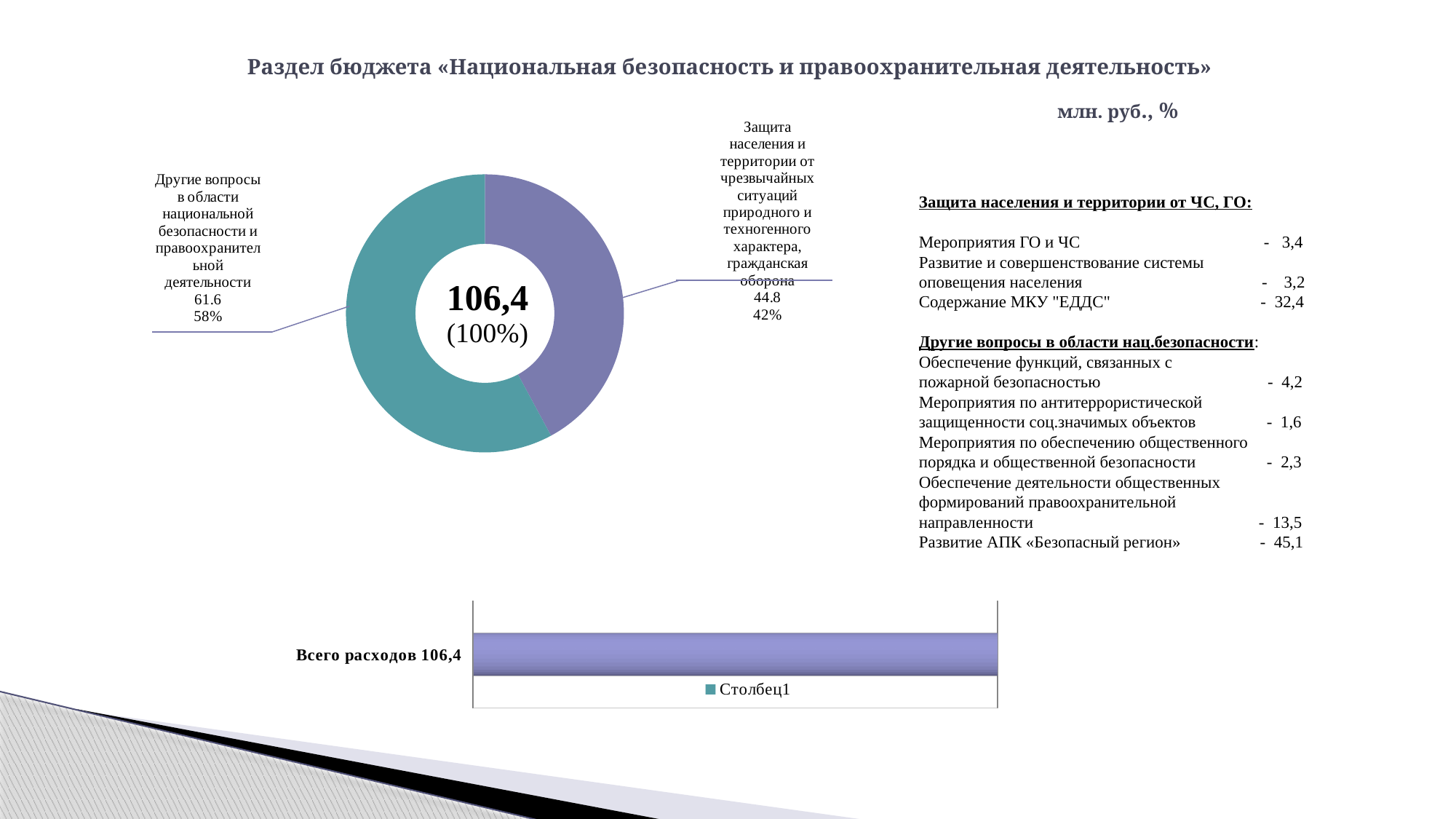
In the donut chart, what value is shown for «Другие вопросы в области национальной безопасности и правоохранительной деятельности»? 61.6 What type of chart is shown on the left side of the slide? Donut (pie) chart In the donut chart, what value is shown for «Защита населения и территории от чрезвычайных ситуаций природного и техногенного характера, гражданская оборона»? 44.8 In the donut chart, what percentage share does «Другие вопросы в области национальной безопасности и правоохранительной деятельности» have? 58% In the bar chart at the bottom of the slide, what is the label of the single bar? Всего расходов 106,4 How many slices does the donut chart have? 2 In the bar chart at the bottom of the slide, what series name does the legend show? Столбец1 In the donut chart, which category has the smaller value? Защита населения и территории от чрезвычайных ситуаций природного и техногенного характера, гражданская оборона What total value is shown in the centre of the donut chart? 106,4 (100%) In the donut chart, what percentage share does «Защита населения и территории от чрезвычайных ситуаций...» have? 42% In the donut chart, which category has the larger value? Другие вопросы в области национальной безопасности и правоохранительной деятельности In the donut chart, what is the difference between the values of the two categories (61.6 and 44.8)? 16.8